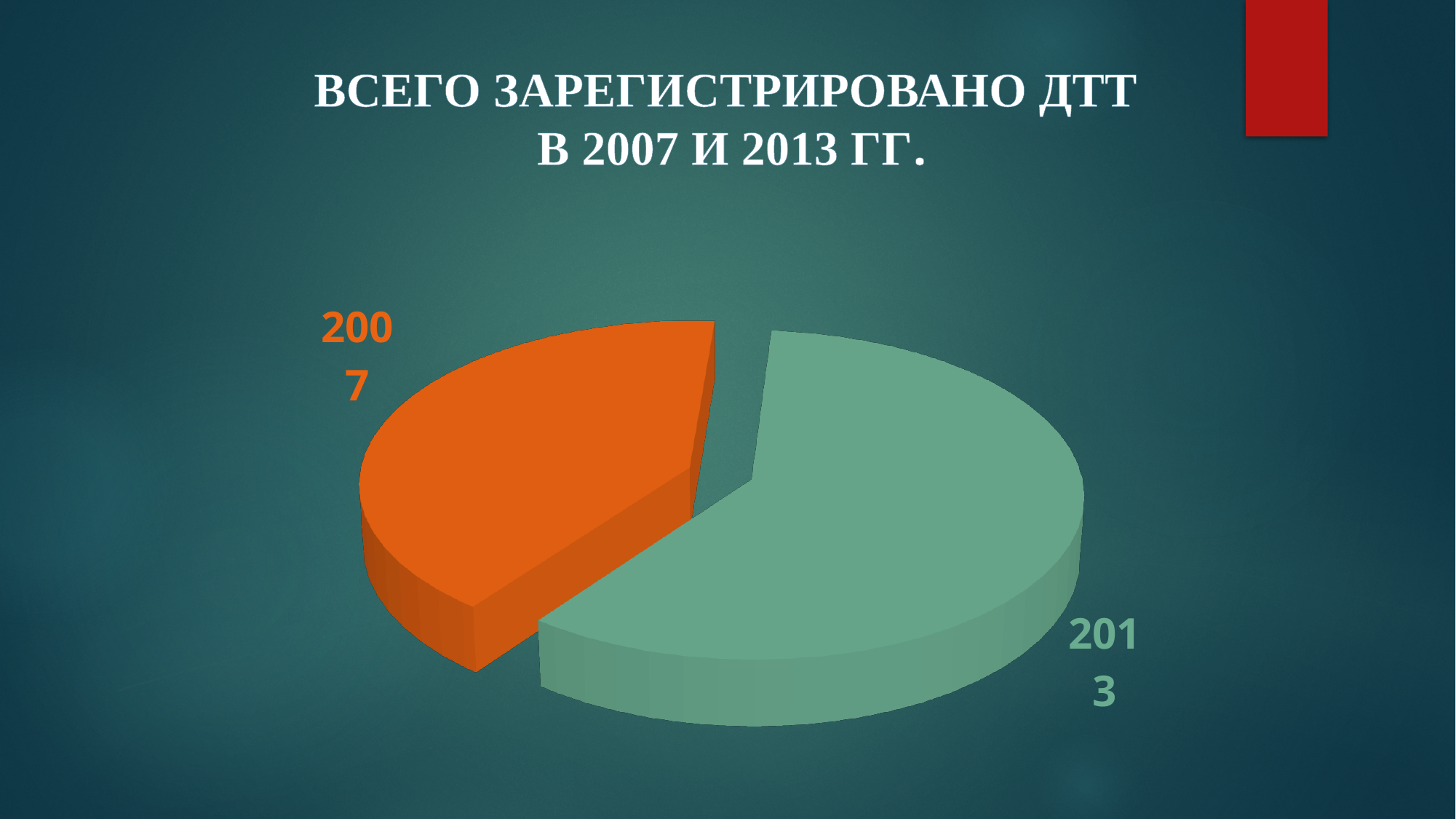
Which category has the smallest slice of the pie chart? 2007 What is the title of the chart? ВСЕГО ЗАРЕГИСТРИРОВАНО ДТТ В 2007 И 2013 ГГ. Which category has the largest slice of the pie chart? 2013 Which slice is larger, 2007 or 2013? 2013 How many slices does the pie chart have? 2 What colour is the slice for 2007? orange Which two years are compared in the pie chart? 2007 and 2013 What kind of chart is shown on the slide? pie chart